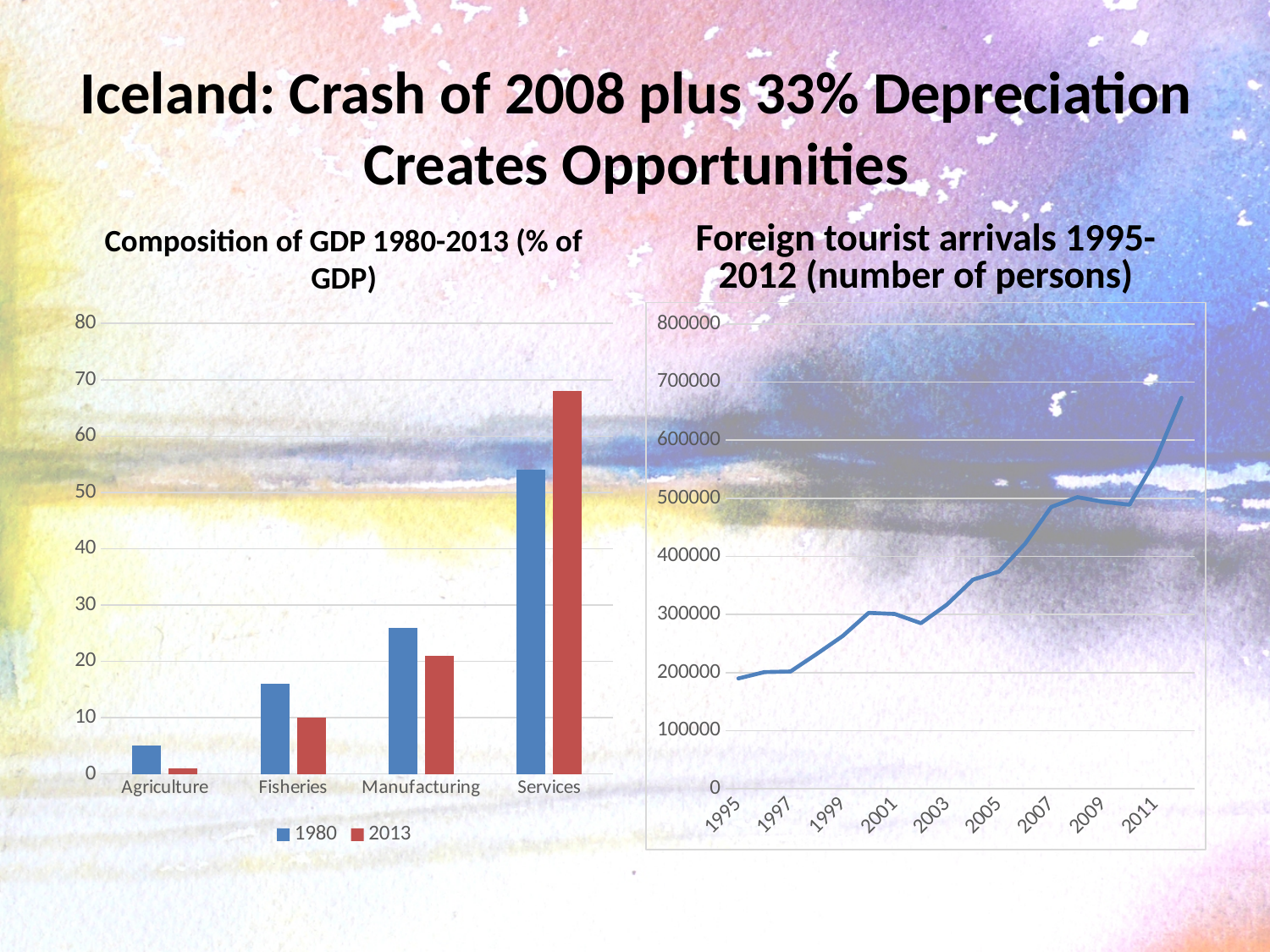
In the 'Composition of GDP 1980-2013 (% of GDP)' chart, what colour are the bars for the 2013 series? red In the 'Composition of GDP 1980-2013 (% of GDP)' chart, which is larger for Manufacturing: the 1980 value or the 2013 value? 1980 How many categories are shown on the x axis of the 'Composition of GDP 1980-2013 (% of GDP)' chart? 4 What kind of chart is the 'Foreign tourist arrivals 1995-2012 (number of persons)' chart? line chart In the 'Foreign tourist arrivals 1995-2012 (number of persons)' chart, do the values generally rise or fall from 1995 to 2012? rise What kind of chart is the 'Composition of GDP 1980-2013 (% of GDP)' chart? bar chart In the 'Composition of GDP 1980-2013 (% of GDP)' chart, which category has the highest value for 2013? Services In the 'Composition of GDP 1980-2013 (% of GDP)' chart, which category has the lowest value for 1980? Agriculture How many series does the legend of the 'Composition of GDP 1980-2013 (% of GDP)' chart list? 2 In the 'Composition of GDP 1980-2013 (% of GDP)' chart, is the 2013 value for Fisheries greater or less than 20? less In the 'Foreign tourist arrivals 1995-2012 (number of persons)' chart, is the value for 1995 greater or less than 300000? less In the 'Composition of GDP 1980-2013 (% of GDP)' chart, is the 1980 value for Services greater or less than 50? greater